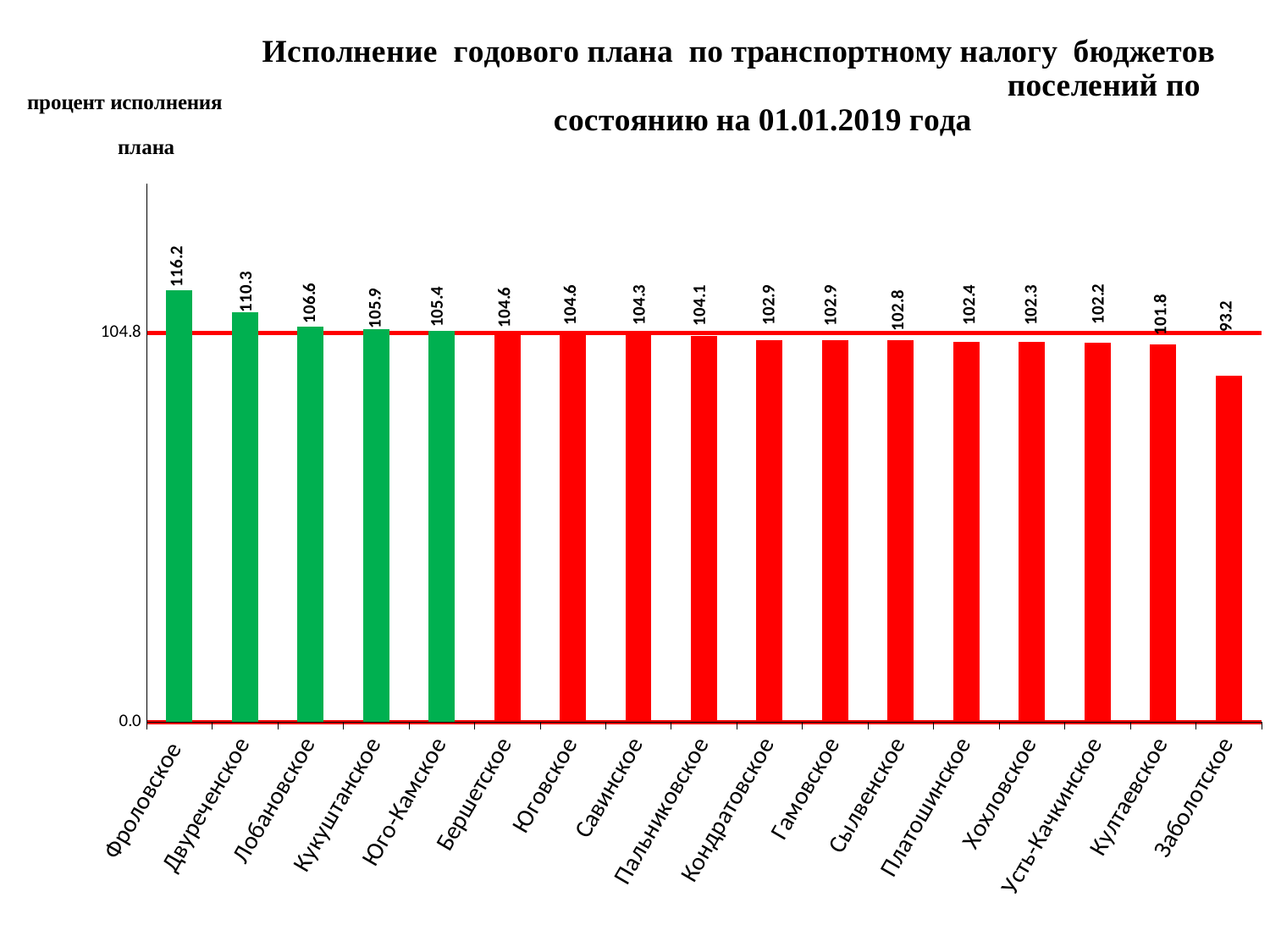
What is the difference between the values for Фроловское and Двуреченское? 5.9 What is the value for Кукуштанское? 105.9 Which category has the highest value? Фроловское What is the value for Фроловское? 116.2 Which category has the lowest value? Заболотское What value is marked by the horizontal red line across the chart? 104.8 What is the value for Сылвенское? 102.8 How many categories are shown on the x axis? 17 What kind of chart is shown on the slide? bar chart Which is larger, the value for Лобановское or the value for Савинское? Лобановское What is the value for Заболотское? 93.2 What is the difference between the values for Култаевское and Заболотское? 8.6